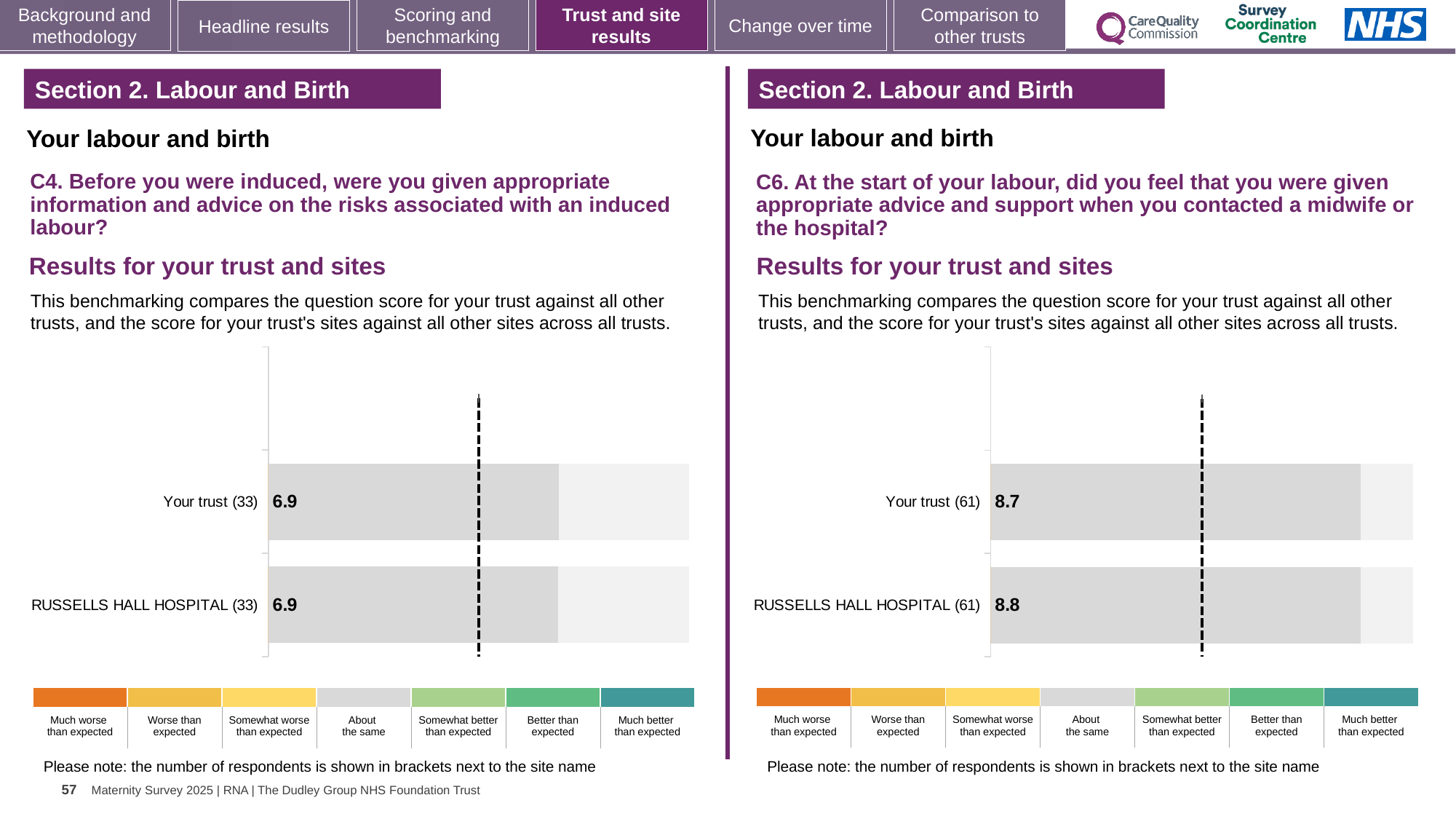
On the right chart (C6), which has the higher score, Your trust or RUSSELLS HALL HOSPITAL? RUSSELLS HALL HOSPITAL On the right chart (C6), how many respondents are shown in brackets for RUSSELLS HALL HOSPITAL? 61 On the right chart (C6), what is the score for Your trust? 8.7 On the right chart (C6), what is the score for RUSSELLS HALL HOSPITAL? 8.8 How many bars are plotted on the left chart (C4)? 2 On the right chart (C6), what is the difference between the RUSSELLS HALL HOSPITAL score and the Your trust score? 0.1 On the left chart (C4), what is the score for Your trust? 6.9 On the left chart (C4), what is the score for RUSSELLS HALL HOSPITAL? 6.9 On the right chart (C6), is the score for Your trust greater or less than 8.8? less On the left chart (C4), how many respondents are shown in brackets for Your trust? 33 What type of chart is used on the right (C6)? Bar chart On the left chart (C4), is the score for Your trust the same as the score for RUSSELLS HALL HOSPITAL? Yes